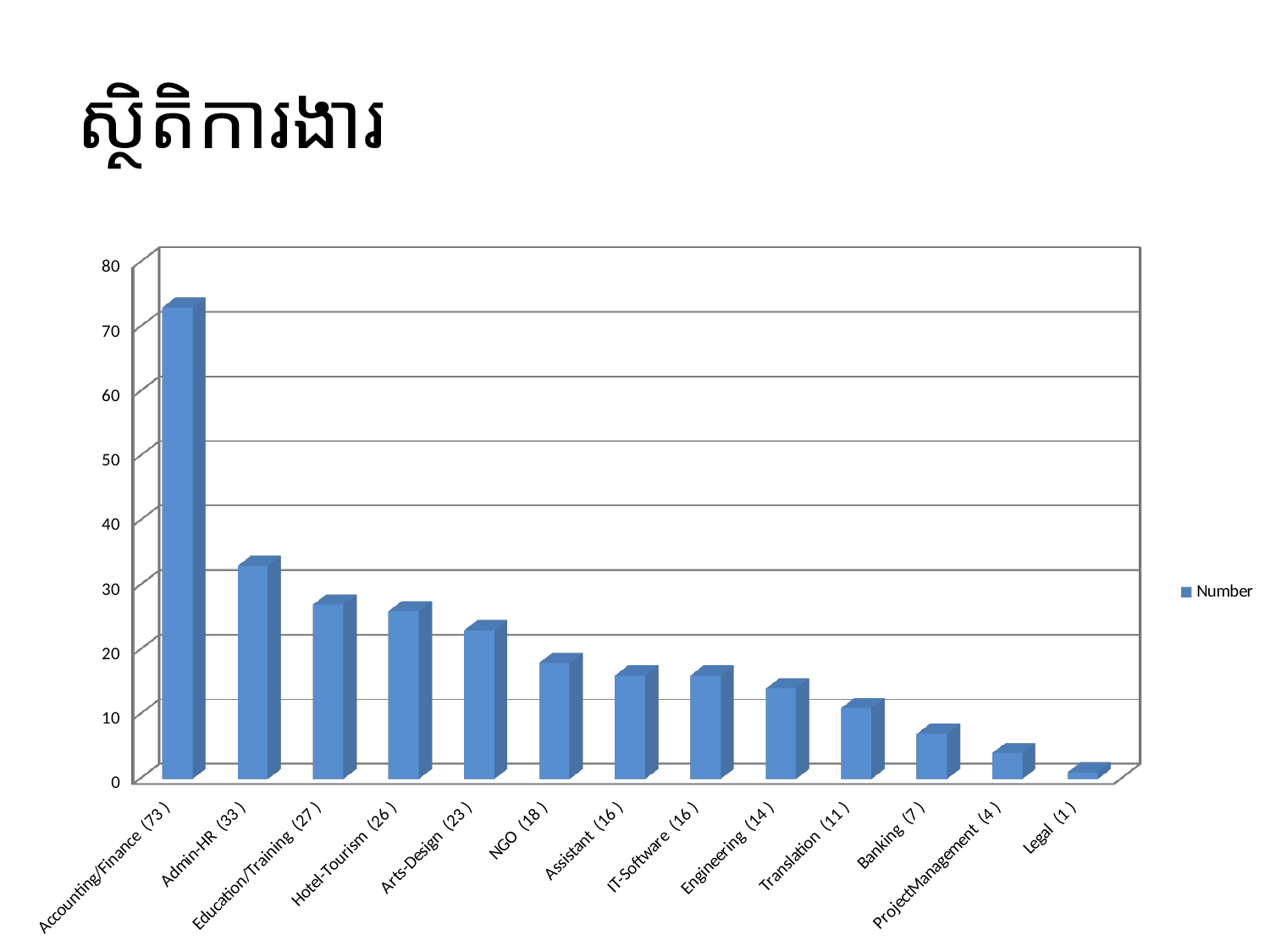
What is the difference between the values for Admin-HR and Education/Training? 6 Is the value for Hotel-Tourism greater or less than 30? less What is the difference between the values for Accounting/Finance and Admin-HR? 40 What is the value for Accounting/Finance? 73 What is the value for Translation? 11 How many series does the legend list? 1 What is the name of the series shown in the legend? Number How many categories are shown on the x axis? 13 Which is larger, the value for NGO or the value for Engineering? NGO What kind of chart is shown on the slide? bar chart Which category has the highest value? Accounting/Finance Which category has the lowest value? Legal